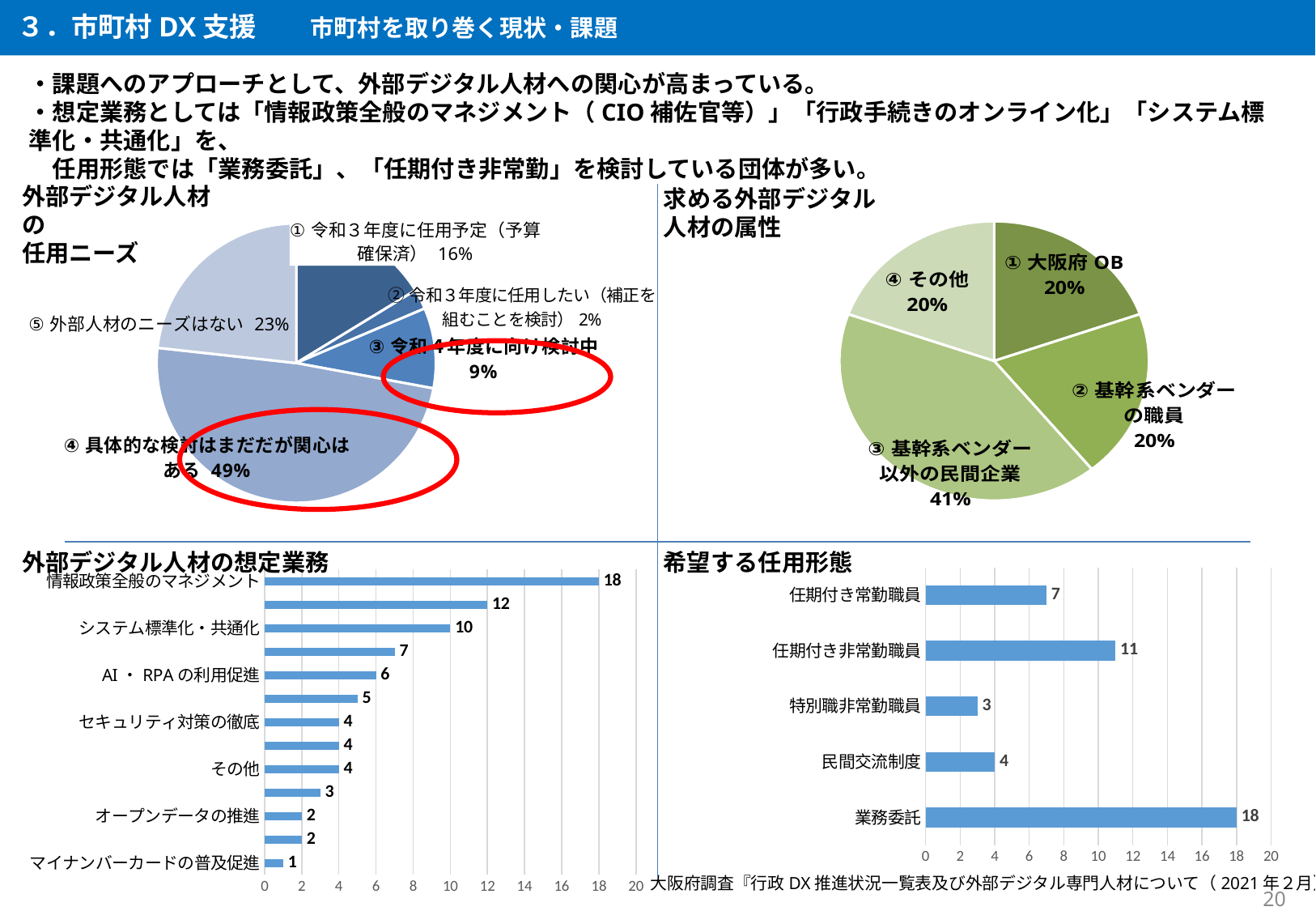
In the 外部デジタル人材の任用ニーズ pie chart, what share is ④ 具体的な検討はまだだが関心はある? 49% In the 求める外部デジタル人材の属性 pie chart, what share is ③ 基幹系ベンダー以外の民間企業? 41% In the 外部デジタル人材の任用ニーズ pie chart, how many slices are there? 5 In the 外部デジタル人材の想定業務 bar chart, which is larger, システム標準化・共通化 or AI・RPAの利用促進? システム標準化・共通化 In the 外部デジタル人材の任用ニーズ pie chart, which category has the smallest share? ② 令和３年度に任用したい（補正を組むことを検討） In the 外部デジタル人材の想定業務 bar chart, what is the value for 情報政策全般のマネジメント? 18 What kind of chart is 希望する任用形態? Bar chart In the 希望する任用形態 bar chart, what is the value for 業務委託? 18 In the 希望する任用形態 bar chart, what is the value for 任期付き非常勤職員? 11 In the 求める外部デジタル人材の属性 pie chart, which category has the largest share? ③ 基幹系ベンダー以外の民間企業 In the 希望する任用形態 bar chart, which category has the lowest value? 特別職非常勤職員 In the 希望する任用形態 bar chart, what is the difference between 業務委託 and 任期付き常勤職員? 11